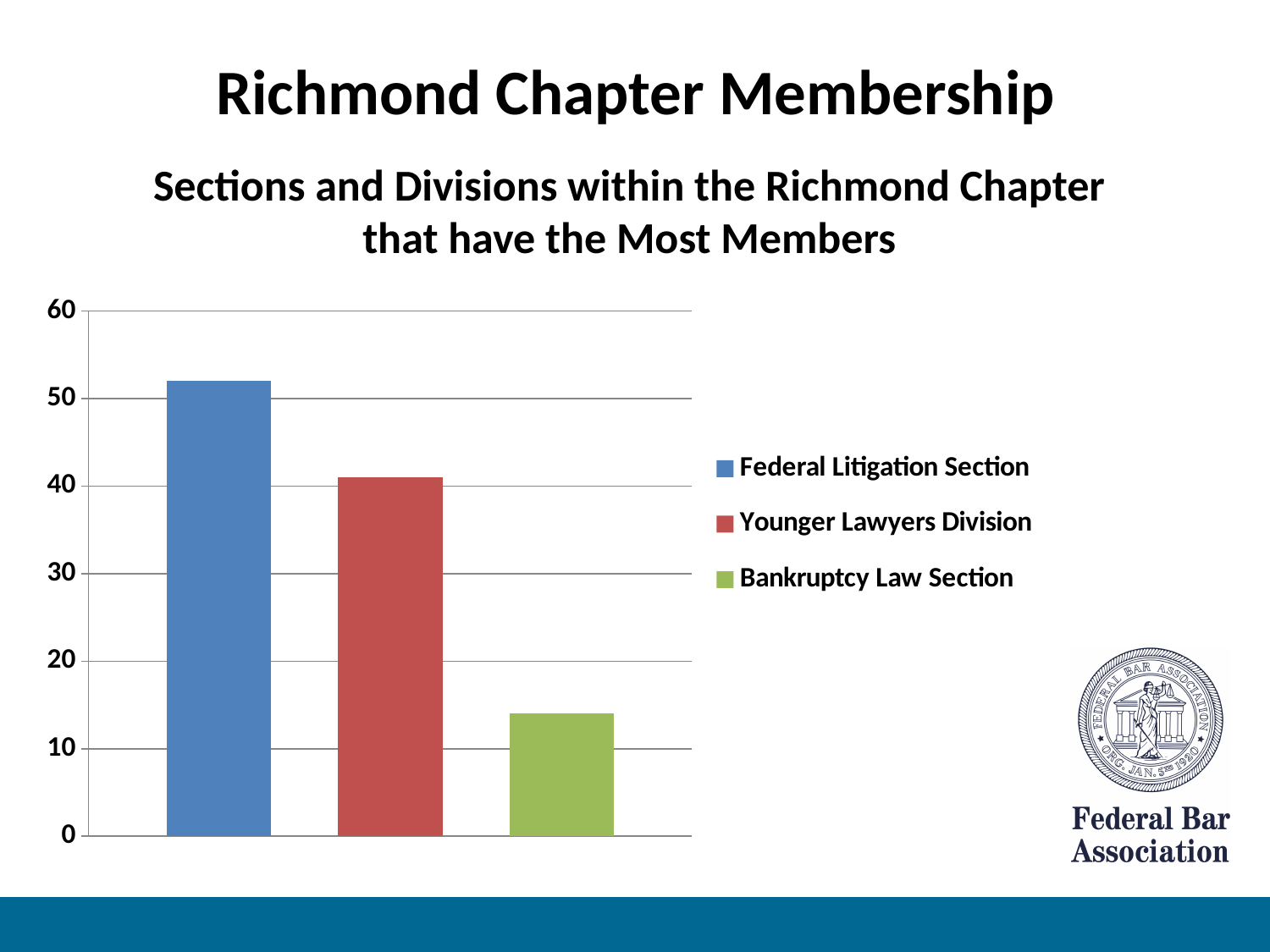
Is the value for Bankruptcy Law Section greater or less than 20? less What colour is the bar for the Younger Lawyers Division? red Which has more members, Younger Lawyers Division or Bankruptcy Law Section? Younger Lawyers Division Which section or division has the most members? Federal Litigation Section How many series does the legend list? 3 What type of chart is shown on the slide? bar chart Which section or division has the fewest members? Bankruptcy Law Section Is the value for Younger Lawyers Division greater or less than 30? greater Is the value for Bankruptcy Law Section greater or less than 10? greater How many bars are plotted in the chart? 3